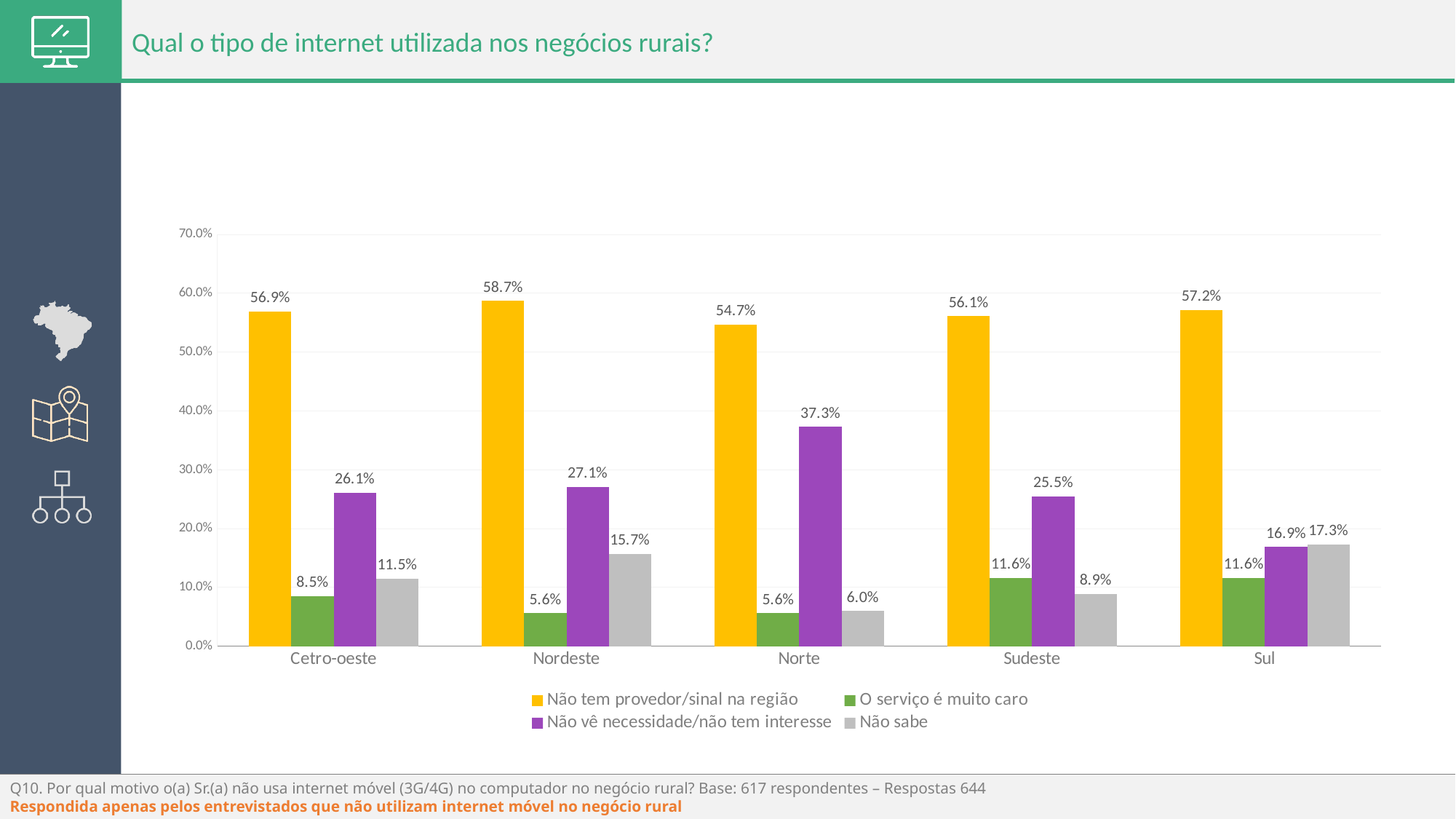
What is the value for "Não vê necessidade/não tem interesse" in Norte? 37.3% What is the value for "Não sabe" in Sul? 17.3% Which is larger in Sul: "Não vê necessidade/não tem interesse" or "Não sabe"? Não sabe How many series does the legend list? 4 How many regions are shown on the x axis? 5 What is the value for "Não tem provedor/sinal na região" in Nordeste? 58.7% Which region has the lowest value for "Não sabe"? Norte What is the value for "O serviço é muito caro" in Sudeste? 11.6% What is the difference between the "Não vê necessidade/não tem interesse" values for Norte and Sudeste? 11.8% What kind of chart is shown on the slide? Bar chart Which region has the highest value for "Não tem provedor/sinal na região"? Nordeste Which colour represents "O serviço é muito caro" in the chart? Green